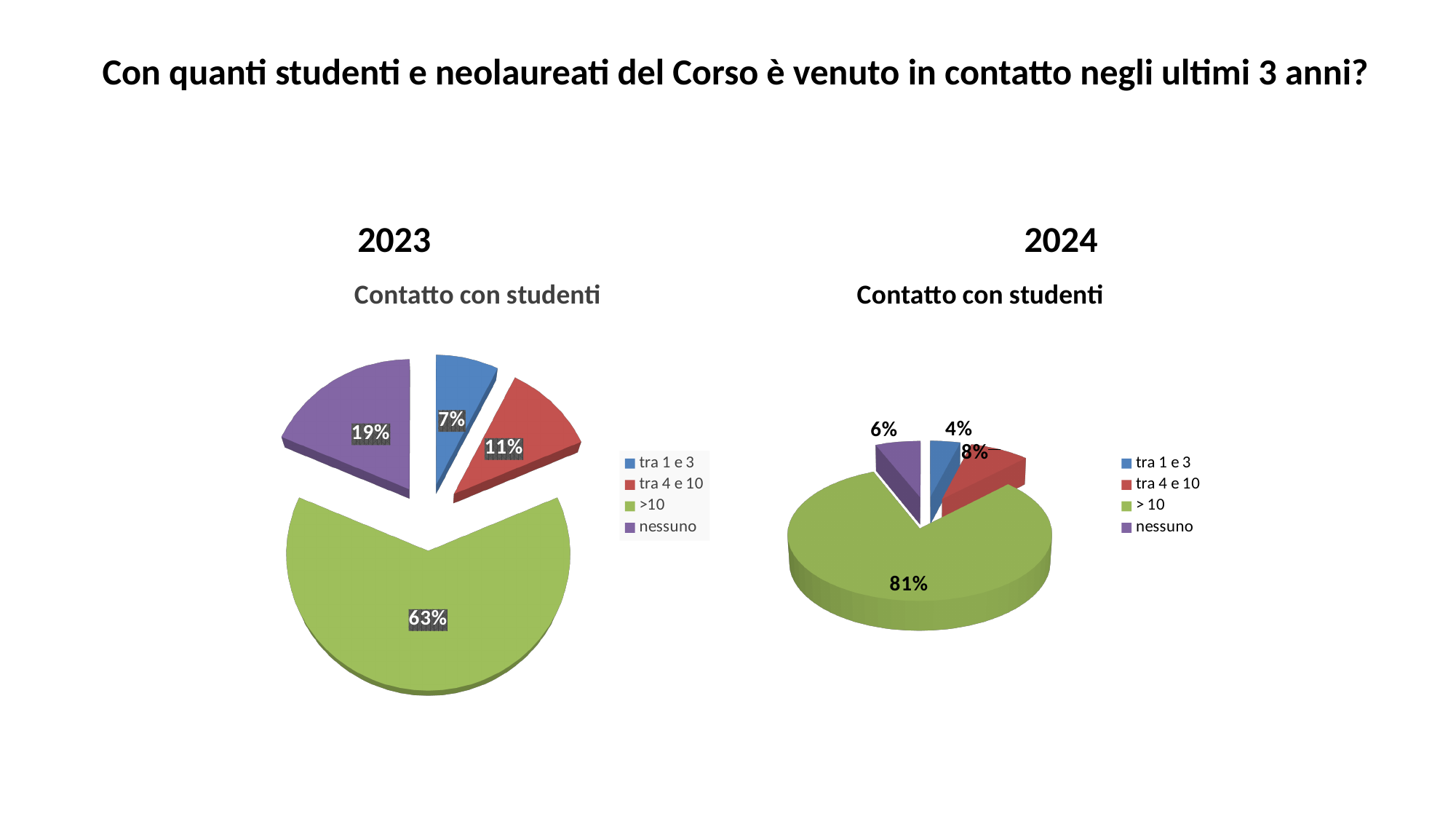
What kind of chart is used for the 2024 'Contatto con studenti' data? Pie chart In the 2024 pie chart, what colour is the '> 10' slice? Green In the 2024 pie chart, which category has the largest slice? > 10 In the 2024 pie chart, what share is labelled for 'tra 4 e 10'? 8% In the 2024 pie chart, what share is labelled for '> 10'? 81% In the 2023 pie chart, what share is labelled for '>10'? 63% In the 2023 pie chart, which category has the smallest slice? tra 1 e 3 What is the title shown above the 2023 pie chart? Contatto con studenti In the 2023 pie chart, what is the difference between the 'nessuno' share and the 'tra 4 e 10' share? 8% In the 2023 pie chart, what share is labelled for 'nessuno'? 19% In the 2024 pie chart, which is larger: 'nessuno' or 'tra 1 e 3'? nessuno How many categories does the legend of the 2023 pie chart list? 4